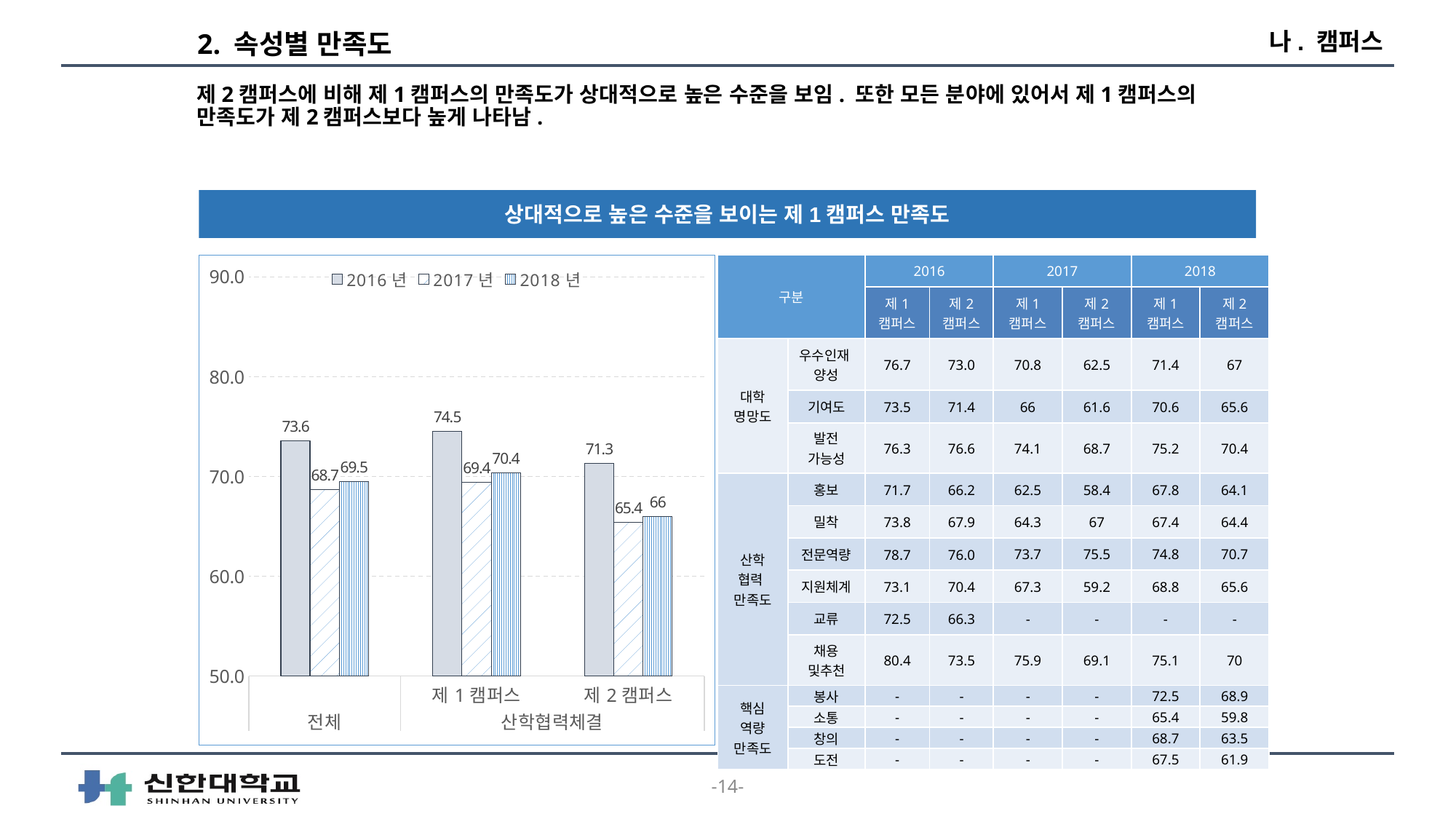
Which is larger for 전체: the 2017 년 value or the 2018 년 value? 2018 년 What is the title shown in the blue banner above the chart? 상대적으로 높은 수준을 보이는 제 1 캠퍼스 만족도 What is the difference between the 2016 년 values for 제 1 캠퍼스 and 제 2 캠퍼스? 3.2 What is the 2016 년 value for 전체? 73.6 What is the 2017 년 value for 제 1 캠퍼스? 69.4 Which category has the highest 2016 년 value? 제 1 캠퍼스 How many categories are shown on the x axis of the chart? 3 How many series does the chart legend list? 3 Is the 2018 년 value for 제 1 캠퍼스 greater or less than 70.0? greater Which category has the lowest 2017 년 value? 제 2 캠퍼스 What type of chart is shown on the slide? bar chart What is the 2018 년 value for 제 2 캠퍼스? 66